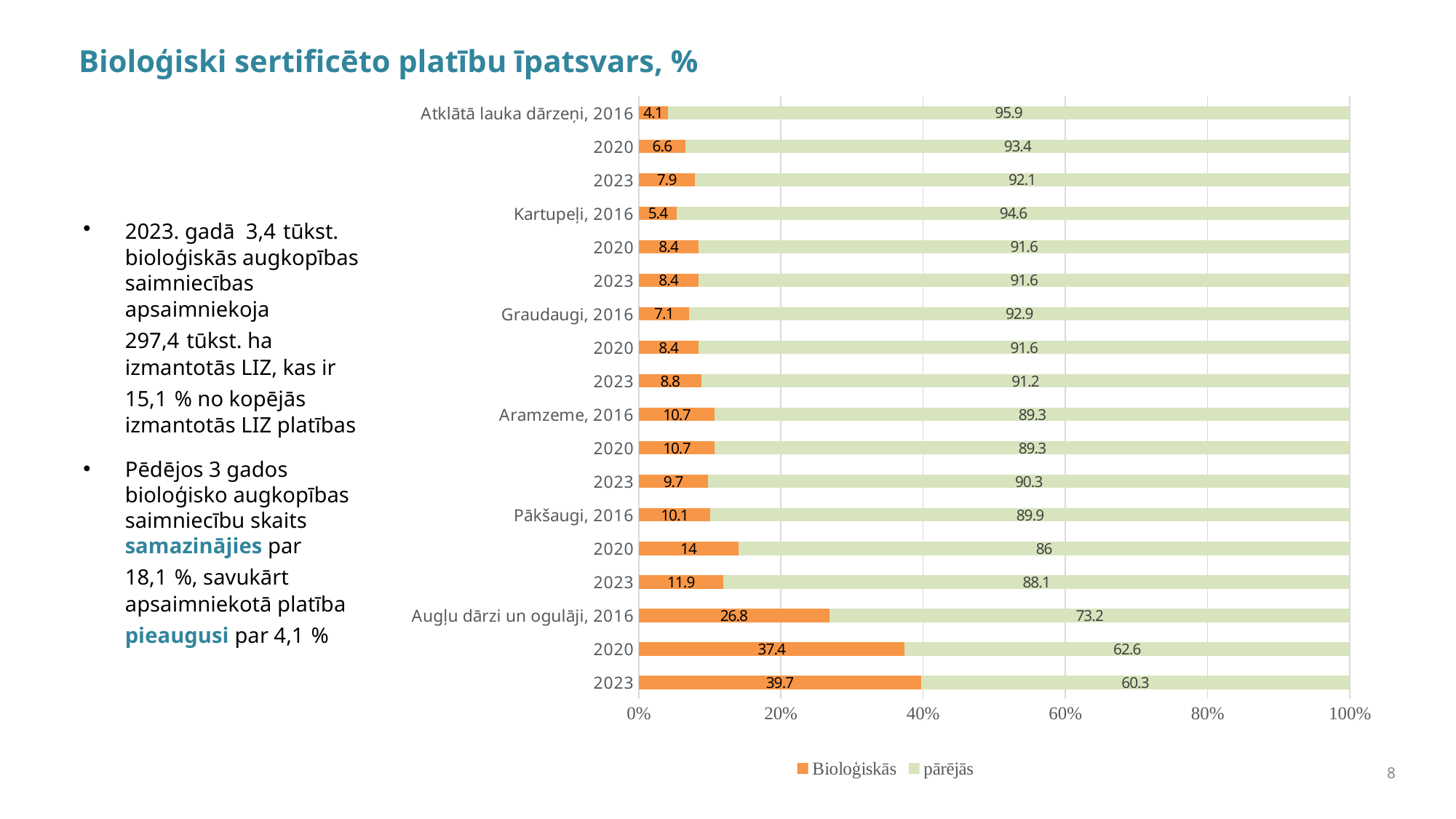
Which bar has the highest Bioloģiskās value? Augļu dārzi un ogulāji, 2023 What is the pārējās value for Kartupeļi in 2016? 94.6 What is the difference between the Bioloģiskās values for Augļu dārzi un ogulāji in 2023 and in 2016? 12.9 What kind of chart is shown on the slide? Stacked bar chart What is the Bioloģiskās value for Augļu dārzi un ogulāji in 2023? 39.7 Is the Bioloģiskās value for Augļu dārzi un ogulāji in 2020 greater or less than 20%? greater How many series does the legend list? 2 Which is larger: the Bioloģiskās value for Pākšaugi in 2020 or for Aramzeme in 2020? Pākšaugi, 2020 Which bar has the lowest Bioloģiskās value? Atklātā lauka dārzeņi, 2016 What is the title of the chart? Bioloģiski sertificēto platību īpatsvars, % How many bars are shown in the chart? 18 What is the Bioloģiskās value for Pākšaugi in 2020? 14